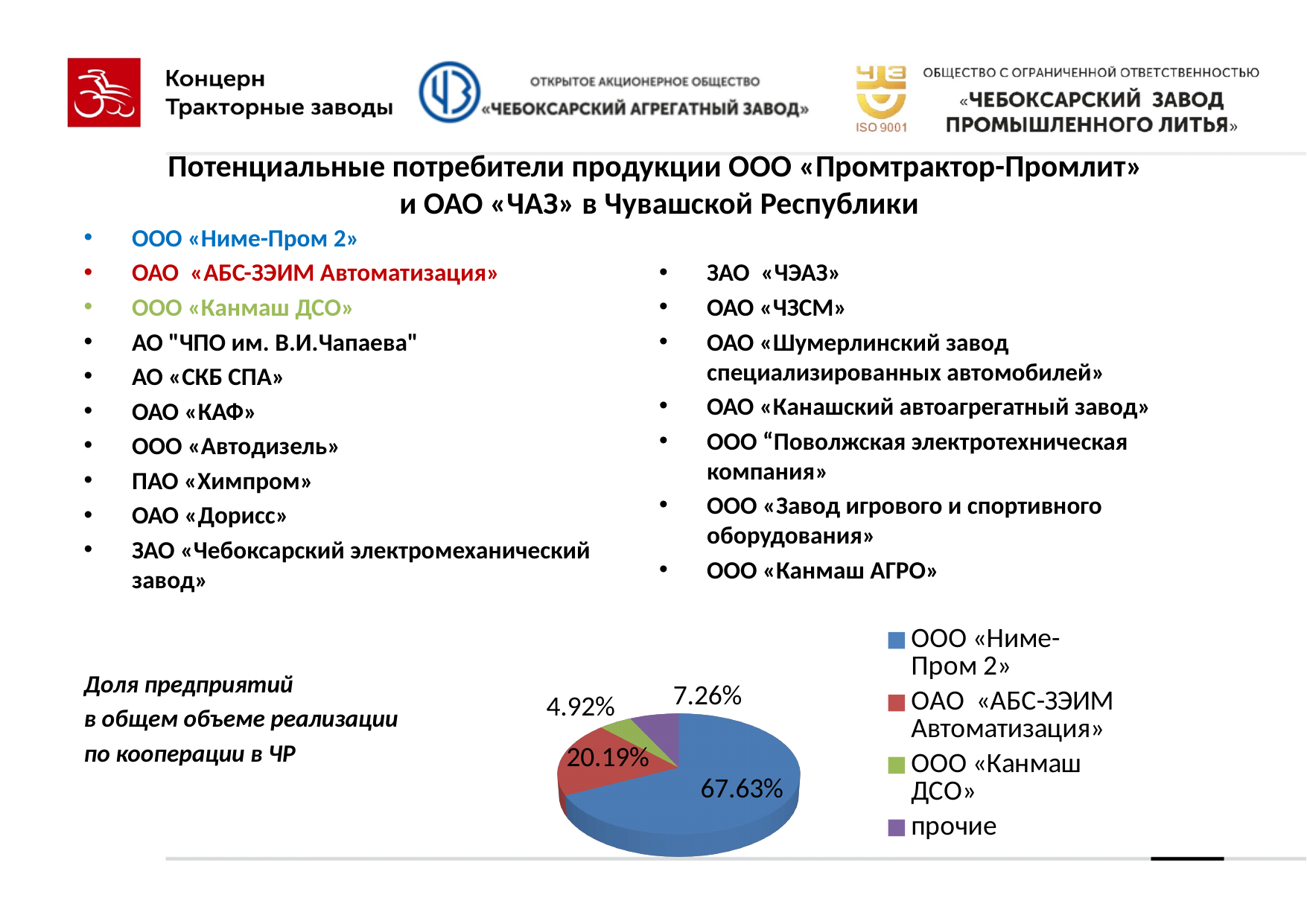
What share of the pie does ООО «Ниме-Пром 2» hold? 67.63% What kind of chart is shown on the slide? pie chart What share of the pie does ООО «Канмаш ДСО» hold? 4.92% How many entries does the legend list? 4 What colour is the slice for ООО «Ниме-Пром 2»? blue Which is larger: the share of ОАО «АБС-ЗЭИМ Автоматизация» or the share of «прочие»? ОАО «АБС-ЗЭИМ Автоматизация» Which category has the smallest slice of the pie? ООО «Канмаш ДСО» Which category has the largest slice of the pie? ООО «Ниме-Пром 2» What is the difference in percentage points between the share of ООО «Ниме-Пром 2» and the share of ОАО «АБС-ЗЭИМ Автоматизация»? 47.44 How many slices does the pie chart have? 4 What share of the pie is labelled «прочие»? 7.26% What share of the pie does ОАО «АБС-ЗЭИМ Автоматизация» hold? 20.19%